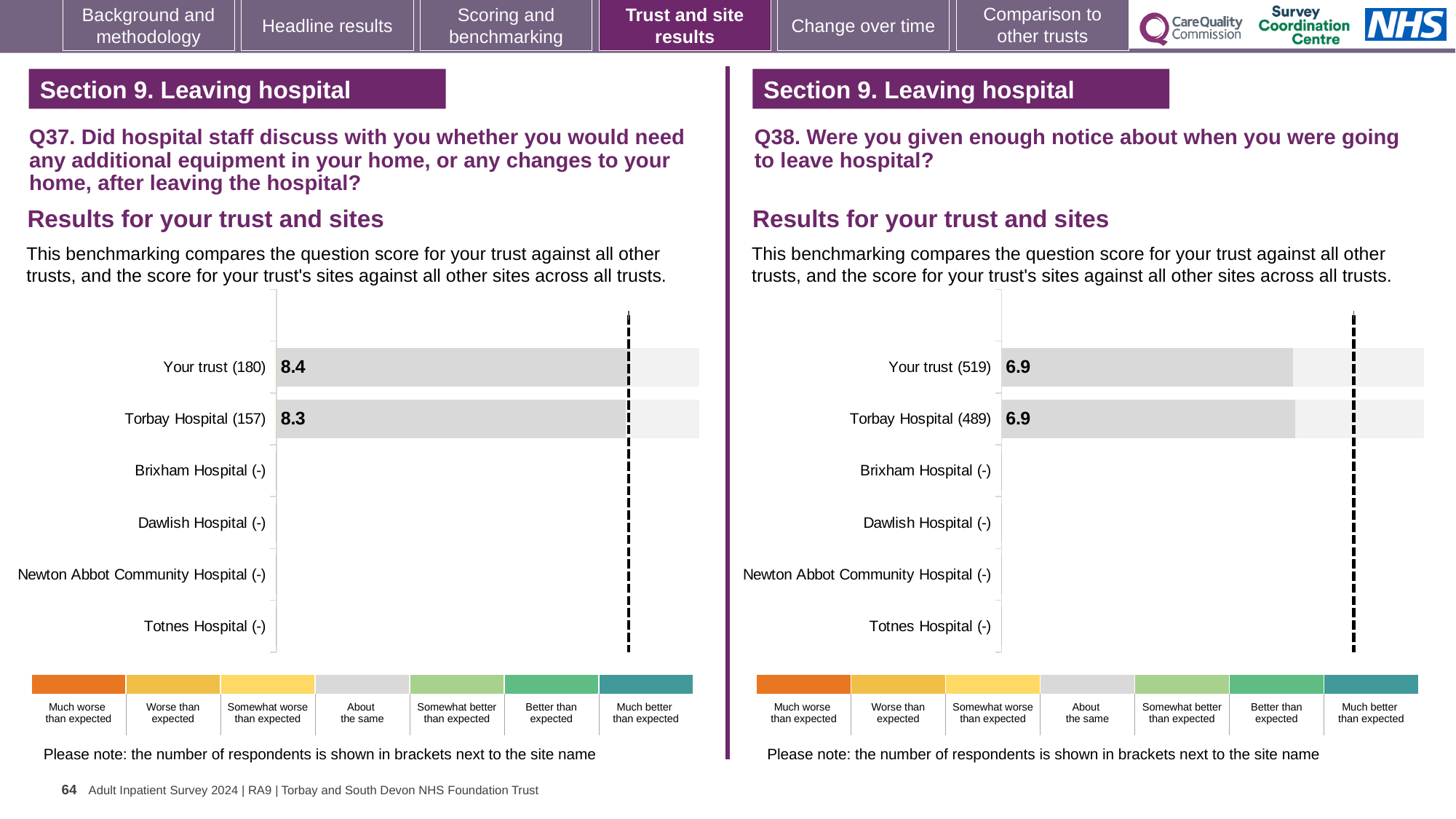
On the Q38 chart (right), how many categories does the colour key below the chart list? 7 On the Q37 chart (left), how many sites or rows are listed on the vertical axis? 6 On the Q37 chart (left), what is the score for Your trust? 8.4 What kind of chart is used on the Q38 chart (right)? Bar chart On the Q37 chart (left), what is the score for Torbay Hospital? 8.3 On the Q38 chart (right), how many sites show no score (marked with a dash)? 4 On the Q37 chart (left), how many respondents are shown in brackets for Your trust? 180 On the Q38 chart (right), how many respondents are shown in brackets for Torbay Hospital? 489 On the Q38 chart (right), what is the score for Torbay Hospital? 6.9 On the Q38 chart (right), what is the score for Your trust? 6.9 On the Q37 chart (left), what is the difference between the Your trust score and the Torbay Hospital score? 0.1 On the Q37 chart (left), which category in the colour key is shown in dark orange at the far left? Much worse than expected